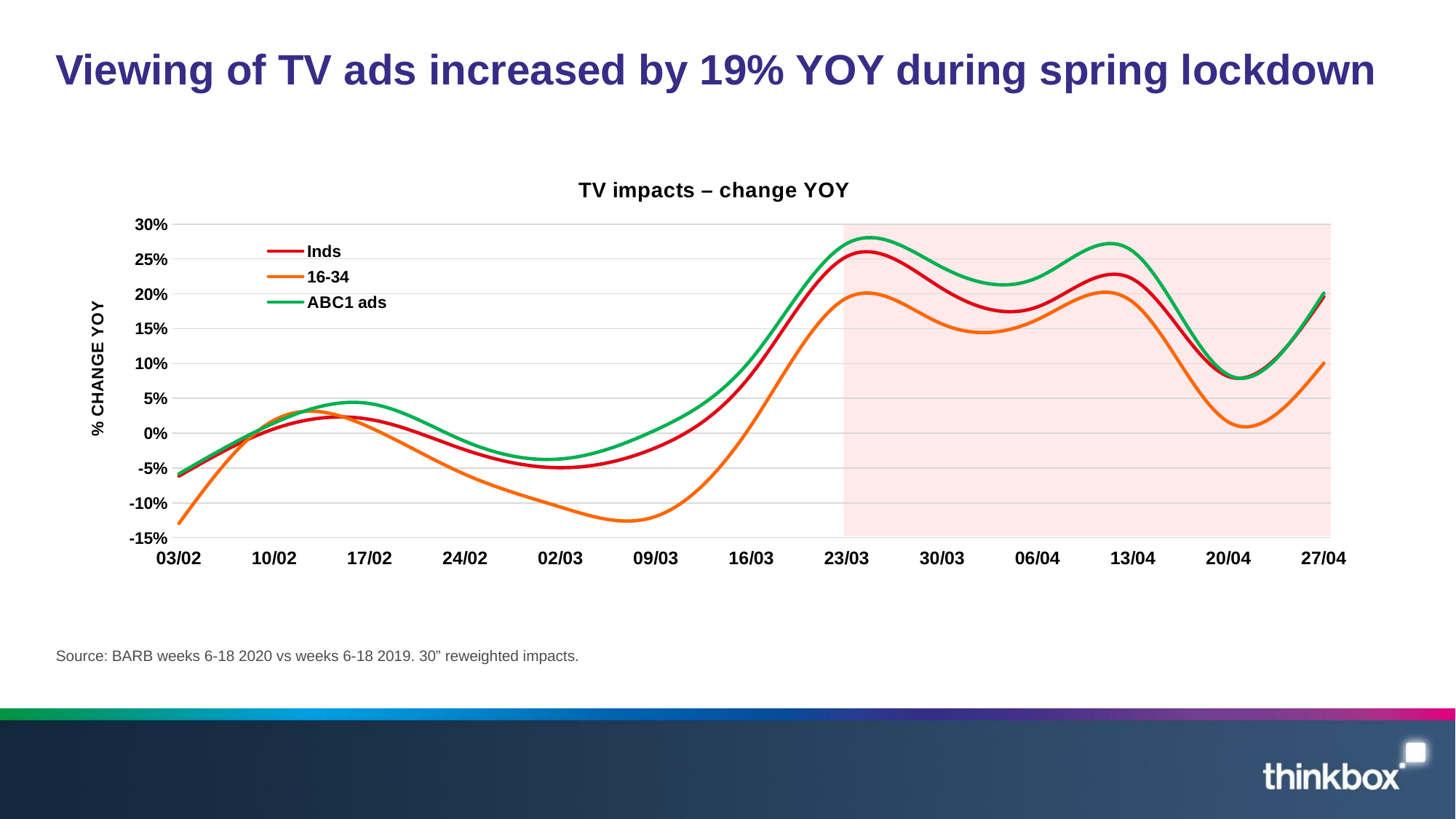
Which series has the lowest value at 09/03? 16-34 Is the value for 16-34 at 09/03 greater or less than -10%? less What is the title of the chart? TV impacts – change YOY Is the value for ABC1 ads at 23/03 greater or less than 25%? greater Do the values for all three series rise or fall between 13/04 and 20/04? fall How many series does the legend list? 3 What is the label on the vertical axis? % CHANGE YOY Which series has the highest value at 13/04? ABC1 ads Is the value for 16-34 at 03/02 greater or less than -10%? less How many dates are labelled along the x axis? 13 What kind of chart is shown on the slide? Line chart